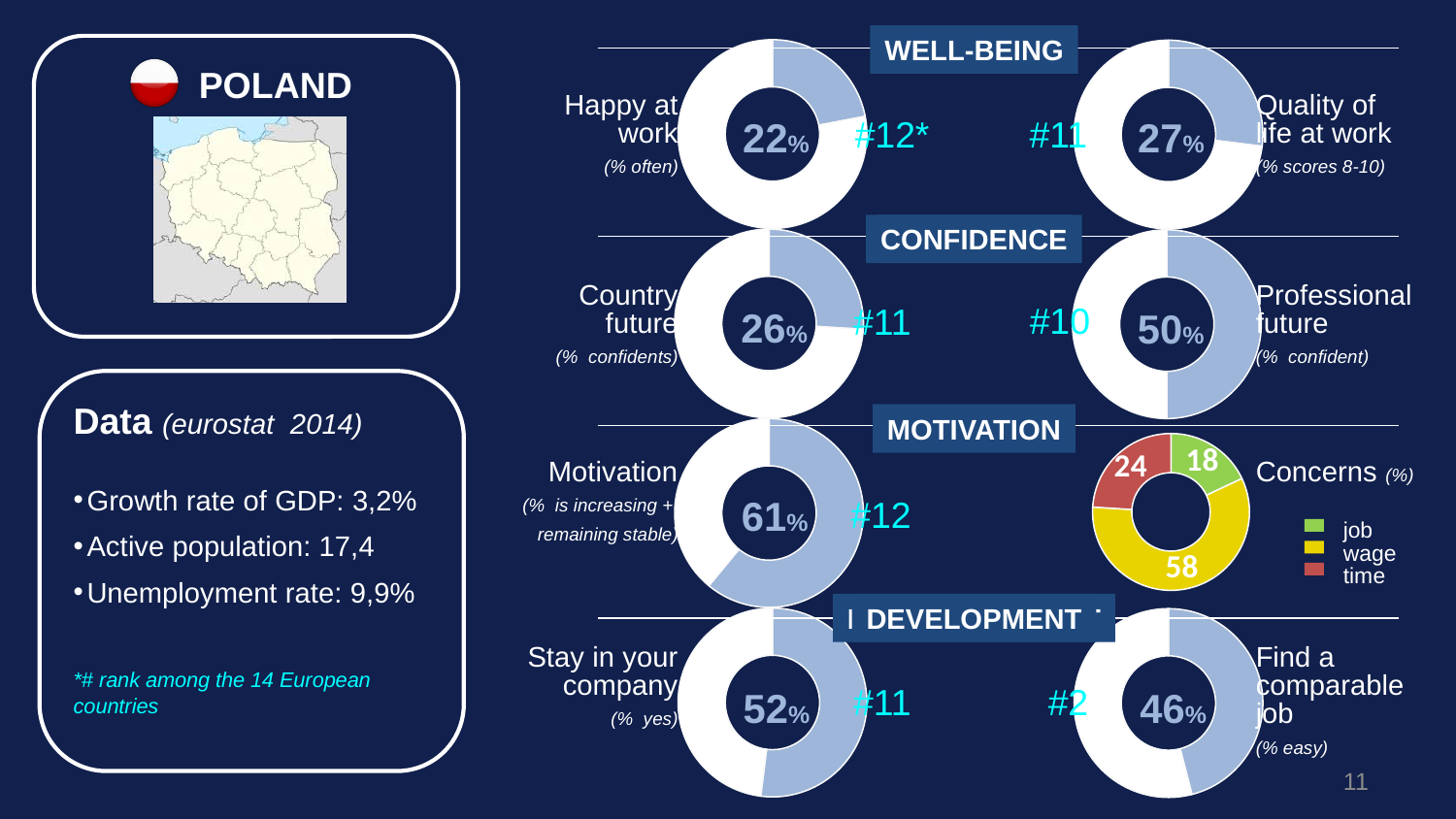
What type of chart is used for the "Concerns" data? Donut (pie) chart On the "Quality of life at work" donut chart, what percentage is shown in the centre? 27% On the "Concerns" donut chart, what is the difference between the wage value and the job value? 40 On the "Professional future" donut chart, what percentage is shown? 50% On the "Concerns" donut chart, which concern has the smallest share? job On the "Concerns" donut chart, what is the value for time? 24 On the "Happy at work" donut chart, what percentage is shown in the centre? 22% Which is larger: the percentage on the "Stay in your company" chart or the percentage on the "Find a comparable job" chart? Stay in your company On the "Concerns" donut chart, what is the value for wage? 58 On the "Concerns" donut chart, which concern has the largest share? wage On the "Motivation" donut chart, what percentage is shown? 61% How many categories does the legend of the "Concerns" donut chart list? 3